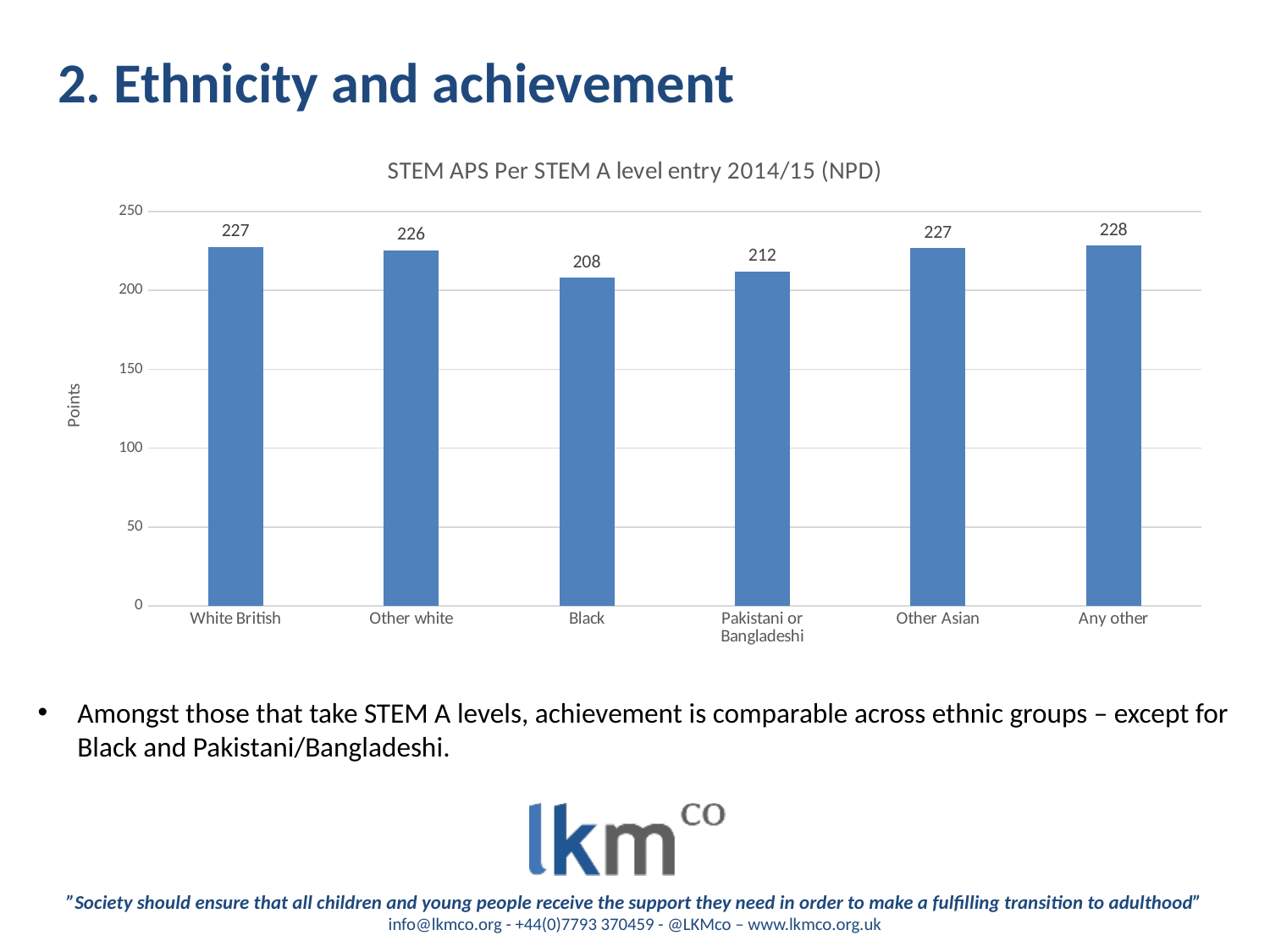
Which category has the highest value? Any other Which is larger, the value for Other white or the value for Pakistani or Bangladeshi? Other white What is the title of the chart? STEM APS Per STEM A level entry 2014/15 (NPD) What is the value for Pakistani or Bangladeshi? 212 What is the value for Black? 208 What is the difference between the values for Pakistani or Bangladeshi and Black? 4 What is the value for White British? 227 What kind of chart is shown on the slide? Bar chart How many categories are shown on the x axis? 6 Which category has the lowest value? Black What is the value for Any other? 228 What is the difference between the values for White British and Black? 19